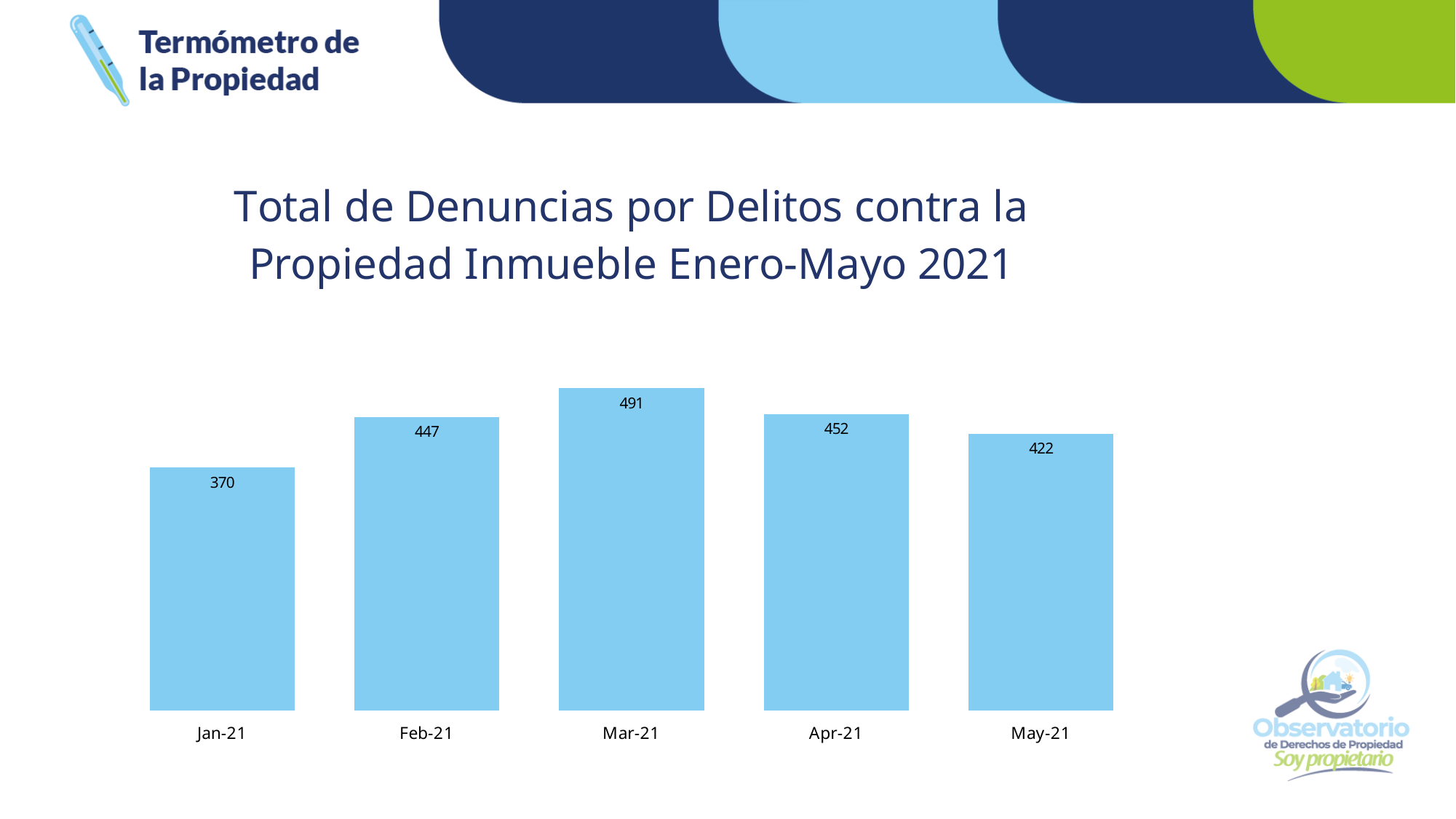
What is the value for Mar-21? 491 Which month has the highest value? Mar-21 What is the difference between the values for Mar-21 and Jan-21? 121 How many months are shown on the chart? 5 What is the value for Jan-21? 370 Do the values rise or fall from Mar-21 to May-21? Fall What is the title of the chart? Total de Denuncias por Delitos contra la Propiedad Inmueble Enero-Mayo 2021 What kind of chart is shown on the slide? Bar chart Which is larger, the value for Feb-21 or the value for May-21? Feb-21 What is the value for May-21? 422 What is the difference between the values for Apr-21 and May-21? 30 Which month has the lowest value? Jan-21